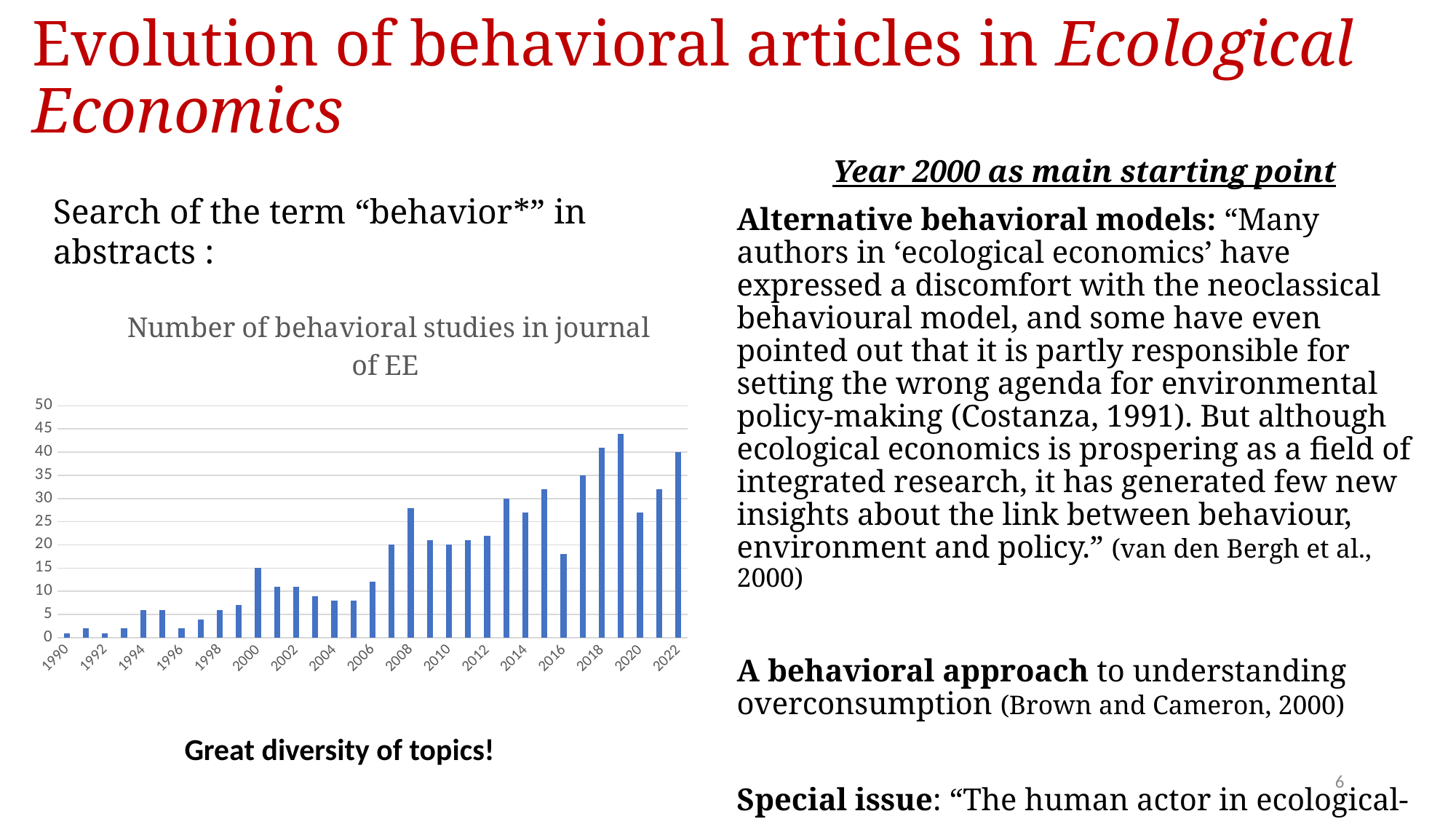
What is the title of the chart? Number of behavioral studies in journal of EE What kind of chart is shown on the slide? bar chart Which year has the larger value, 2015 or 2016? 2015 What is the highest value shown on the vertical axis? 50 Is the value for 2008 greater or less than 25? greater Overall, do the values rise or fall from 1990 to 2022? rise Is the value for 2004 greater or less than 10? less Which year has the larger value, 2019 or 2020? 2019 Is the value for 1999 greater or less than 10? less Which year has the highest number of behavioral studies? 2019